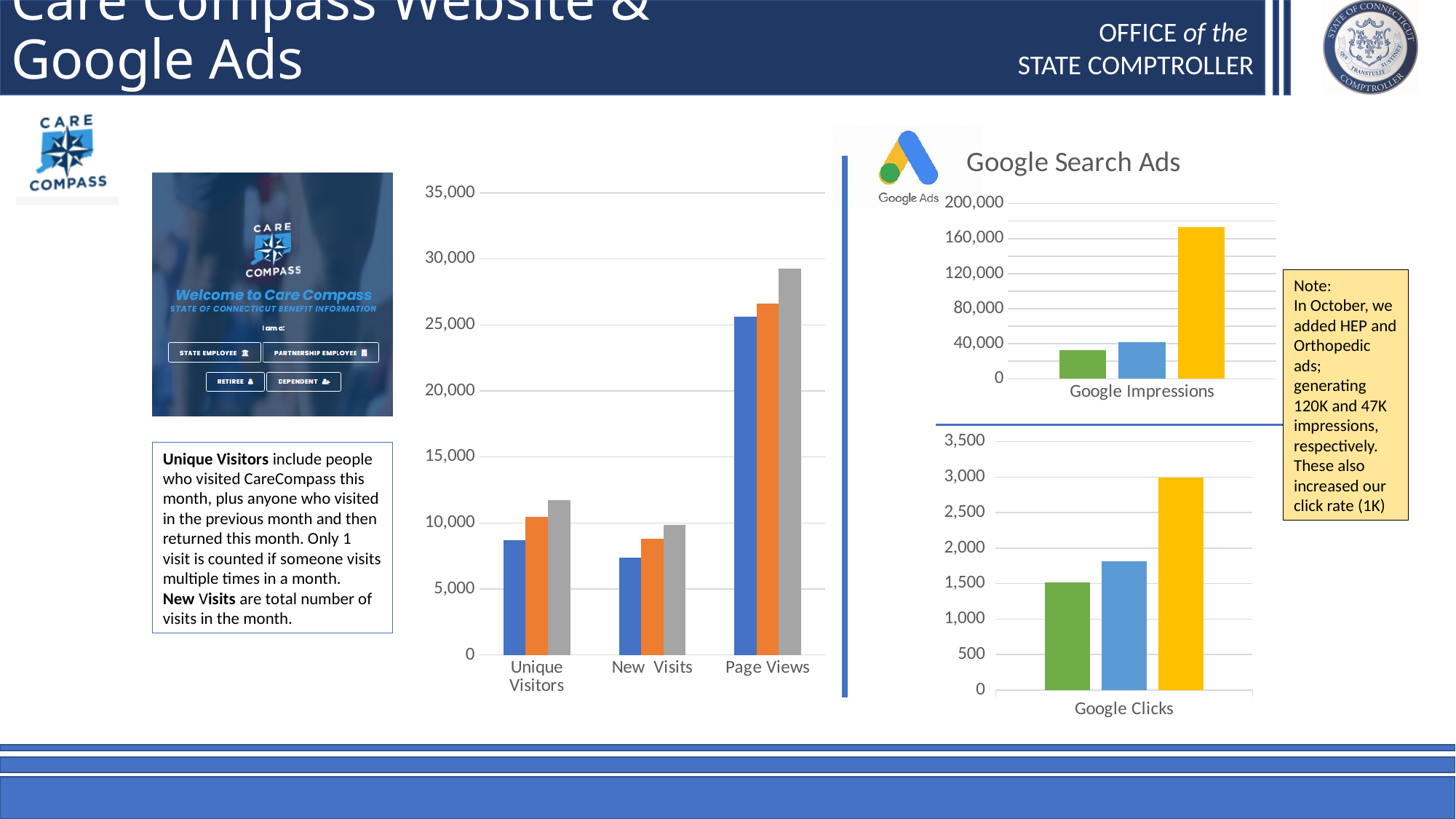
On the chart with Unique Visitors, New Visits and Page Views, is the gray bar for Page Views greater or less than 25,000? greater On the Google Clicks chart, is the value of the yellow bar greater or less than 2,500? greater On the chart with Unique Visitors, New Visits and Page Views, which category has the highest bars? Page Views On the Google Clicks chart, which coloured bar is the lowest? green How many categories are shown on the x axis of the chart with Unique Visitors, New Visits and Page Views? 3 On the chart with Unique Visitors, New Visits and Page Views, is the orange bar larger for Unique Visitors or for New Visits? Unique Visitors On the chart with Unique Visitors, New Visits and Page Views, is the blue bar for New Visits greater or less than 10,000? less How many bars are shown on the Google Impressions chart? 3 On the Google Clicks chart, do the bars rise or fall from left to right? rise What kind of chart is the chart with the categories Unique Visitors, New Visits and Page Views? bar chart